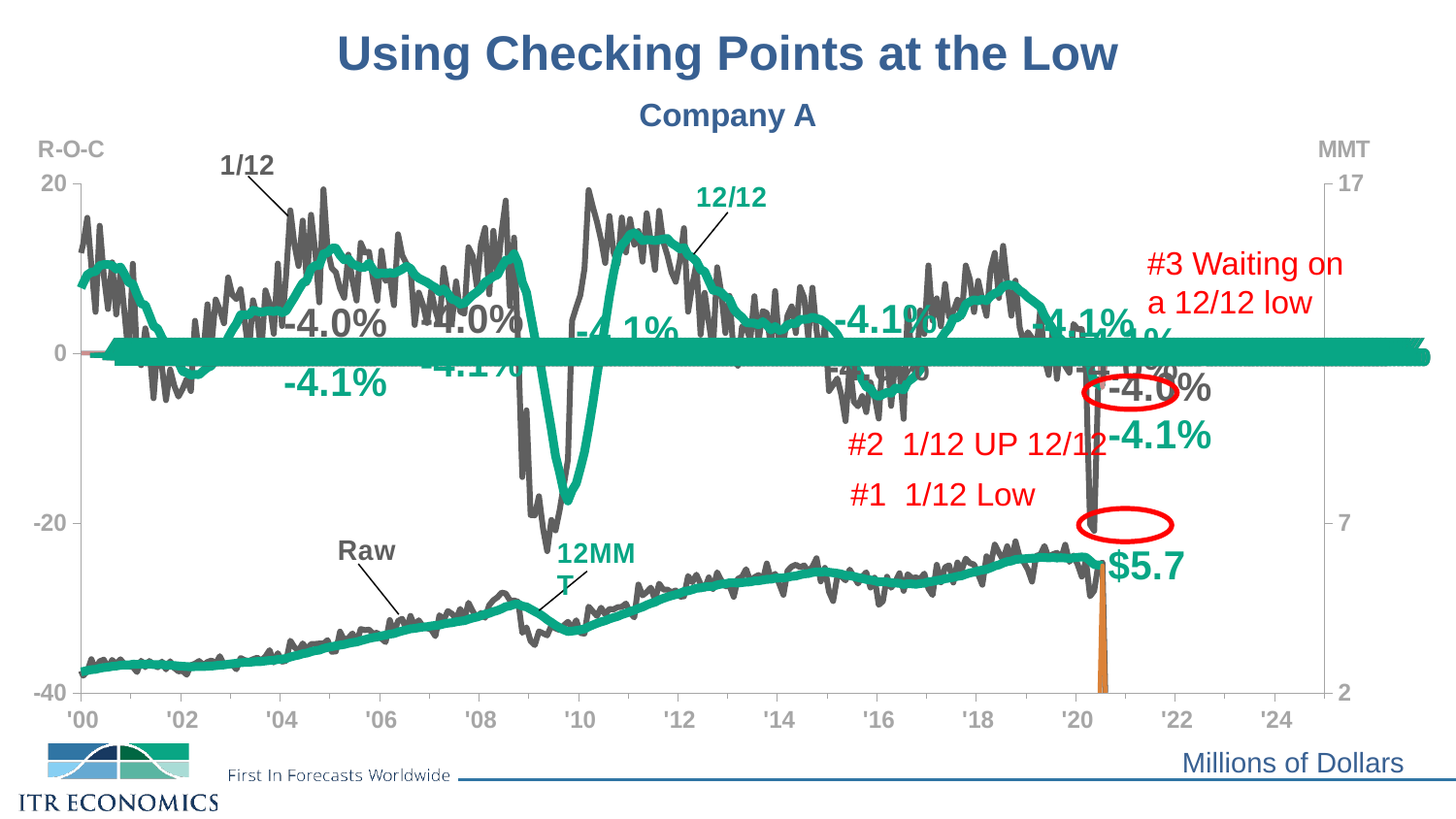
What is the latest 12/12 rate-of-change value labeled on the chart? -4.1% How many named data series are labeled on the chart (1/12, 12/12, Raw, 12MMT)? 4 Which is larger, the latest 1/12 value of -4.0% or the latest 12/12 value of -4.1%? -4.0% (1/12) What kind of chart is shown on the slide? line chart What is the latest 1/12 rate-of-change value labeled on the chart? -4.0% Is the 12/12 rate-of-change at its 2011 peak greater or less than 10? greater Which is higher, the 12/12 rate-of-change in 2011 or in 2009? 2011 What is the latest 12MMT value labeled on the chart? $5.7 Does the 12MMT line generally rise or fall from '00 to '20? rise What unit is stated for the data at the bottom right of the chart? Millions of Dollars What is the title of the chart? Using Checking Points at the Low Is the 12/12 rate-of-change at its 2009 low greater or less than -10? less